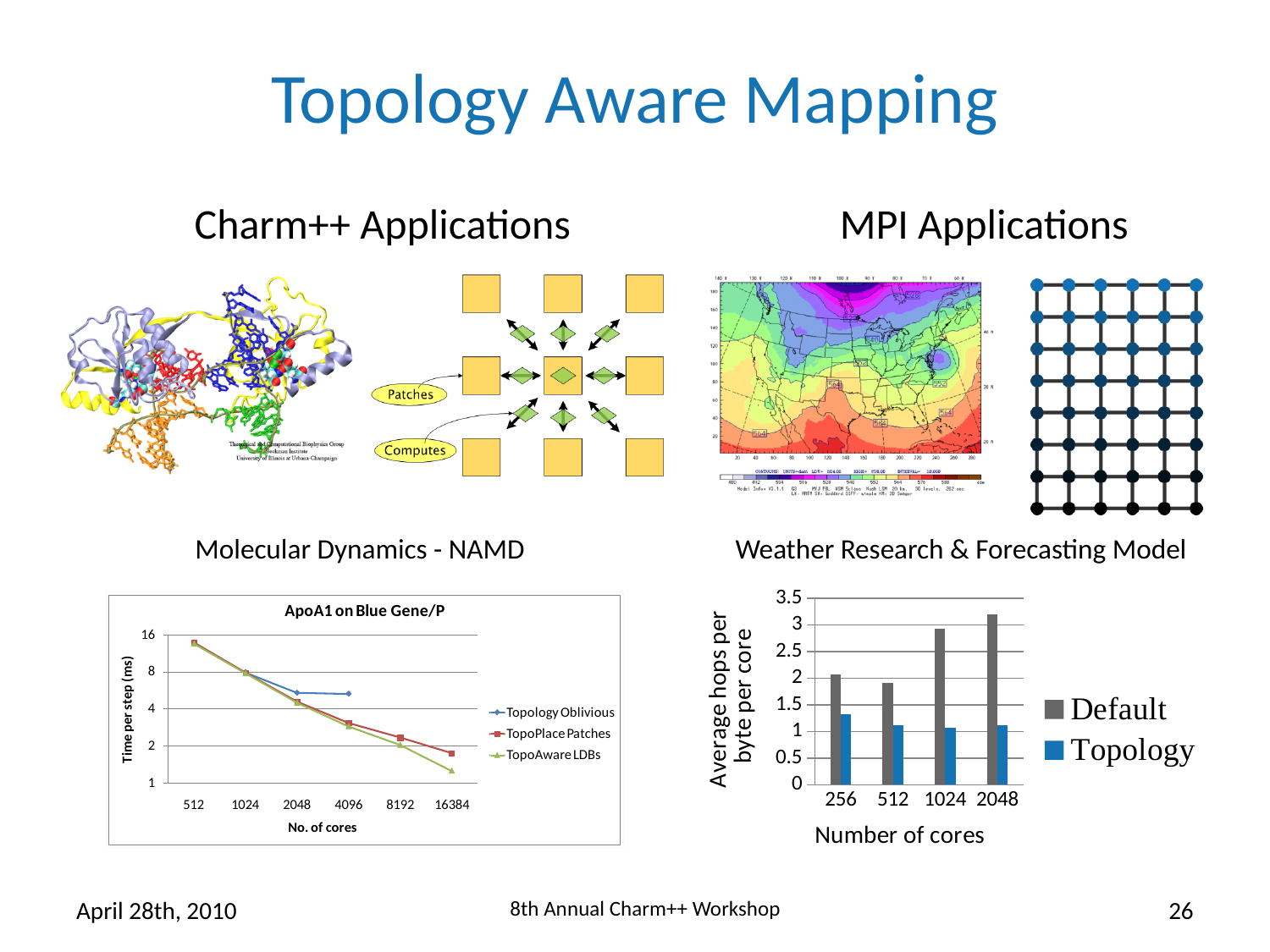
How many core counts are shown on the x axis of the 'Average hops per byte per core' bar chart? 4 In the 'Average hops per byte per core' bar chart, at which number of cores is the Default value highest? 2048 In the 'ApoA1 on Blue Gene/P' chart, which series has the lower time per step at 16384 cores, TopoPlace Patches or TopoAware LDBs? TopoAware LDBs In the 'Average hops per byte per core' bar chart, is the Default value at 2048 cores greater or less than 3? greater How many core counts are shown on the x axis of the 'ApoA1 on Blue Gene/P' chart? 6 How many series does the legend of the 'Average hops per byte per core' bar chart list? 2 In the 'Average hops per byte per core' bar chart, which is larger at 1024 cores, Default or Topology? Default How many series does the legend of the 'ApoA1 on Blue Gene/P' chart list? 3 What kind of chart is the 'Average hops per byte per core' chart on the right? bar chart What kind of chart is the 'ApoA1 on Blue Gene/P' chart on the left? line chart In the 'Average hops per byte per core' bar chart, is the Topology value at 1024 cores greater or less than 1.5? less In the 'ApoA1 on Blue Gene/P' chart, does time per step rise or fall as the number of cores increases? fall